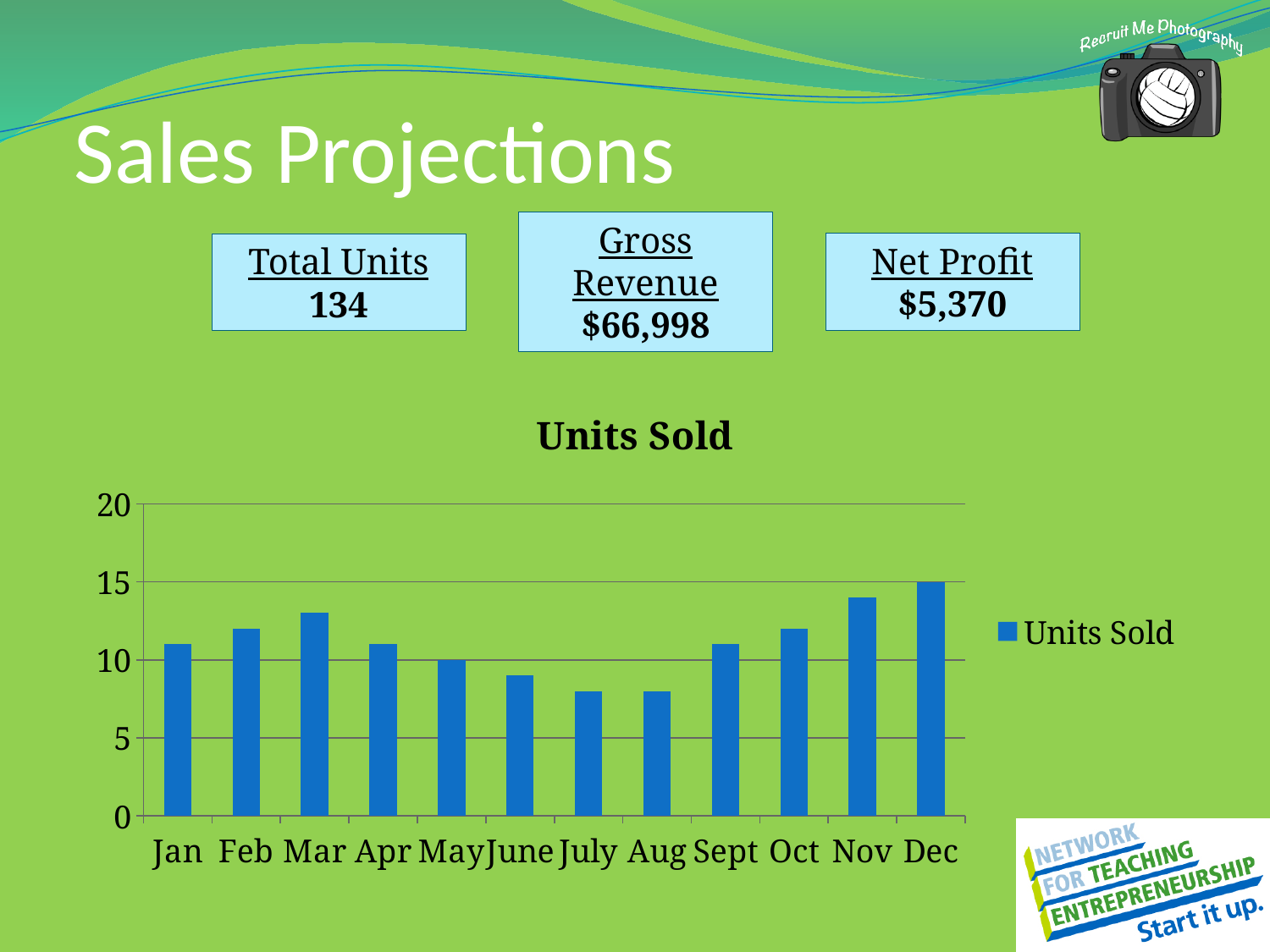
Do the units sold rise or fall from Aug to Dec? rise What is the value for Dec in the Units Sold chart? 15 How many series does the chart legend list? 1 How many months are shown on the x axis of the chart? 12 What kind of chart is shown on the slide? bar chart What is the title of the chart? Units Sold What is the value for May in the Units Sold chart? 10 Is the value for Nov greater or less than 10? greater Is the value for July greater or less than 10? less Which month has the highest units sold? Dec Which is larger, the units sold in Mar or in June? Mar Is the value for Mar greater or less than 15? less